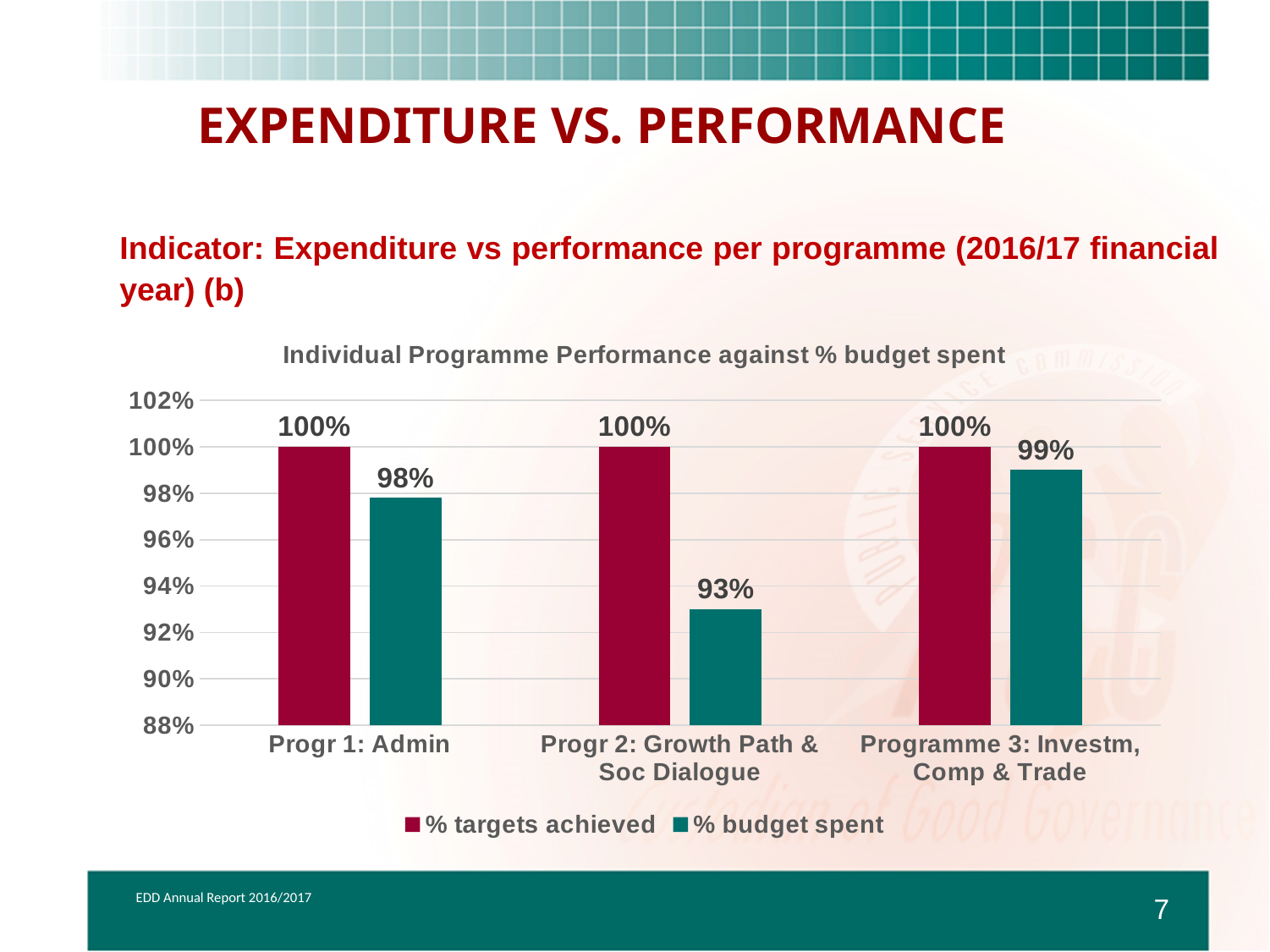
What type of chart is shown on the slide? Bar chart Is the % budget spent for Progr 2: Growth Path & Soc Dialogue greater or less than 96%? less Which is larger for Progr 1: Admin, % targets achieved or % budget spent? % targets achieved What is the % targets achieved for Programme 3: Investm, Comp & Trade? 100% How many series does the chart legend list? 2 How many programmes are shown on the x axis of the chart? 3 What is the difference between % targets achieved and % budget spent for Progr 2: Growth Path & Soc Dialogue? 7% What is the % budget spent for Progr 2: Growth Path & Soc Dialogue? 93% Which programme has the lowest % budget spent? Progr 2: Growth Path & Soc Dialogue What is the % budget spent for Progr 1: Admin? 98% What is the difference in % budget spent between Programme 3: Investm, Comp & Trade and Progr 1: Admin? 1% Which programme has the highest % budget spent? Programme 3: Investm, Comp & Trade